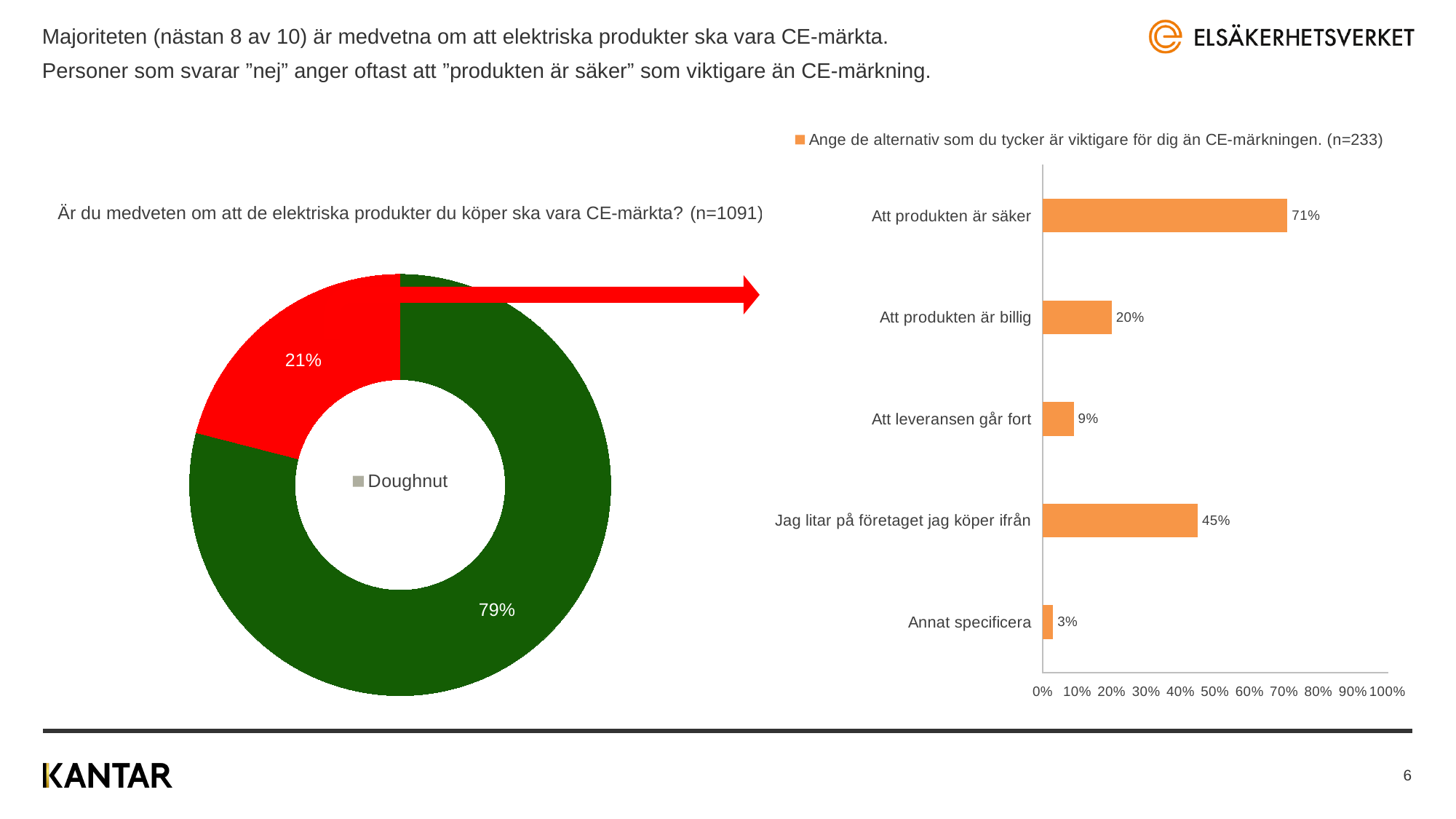
How many categories are shown in the bar chart on the right? 5 In the bar chart on the right, what is the difference between "Att produkten är säker" and "Jag litar på företaget jag köper ifrån"? 26% In the bar chart on the right, what is the value for "Att produkten är säker"? 71% In the bar chart on the right, what is the value for "Att leveransen går fort"? 9% In the bar chart on the right, which is larger: "Att produkten är billig" or "Att leveransen går fort"? Att produkten är billig What is the sample size (n) given in the title of the doughnut chart on the left? 1091 In the bar chart on the right, which category has the highest value? Att produkten är säker In the bar chart on the right, what is the value for "Jag litar på företaget jag köper ifrån"? 45% In the bar chart on the right, which category has the lowest value? Annat specificera In the doughnut chart on the left, what percentage does the green slice show? 79% What kind of chart is on the right side of the slide? Bar chart In the doughnut chart on the left, what percentage does the red slice show? 21%